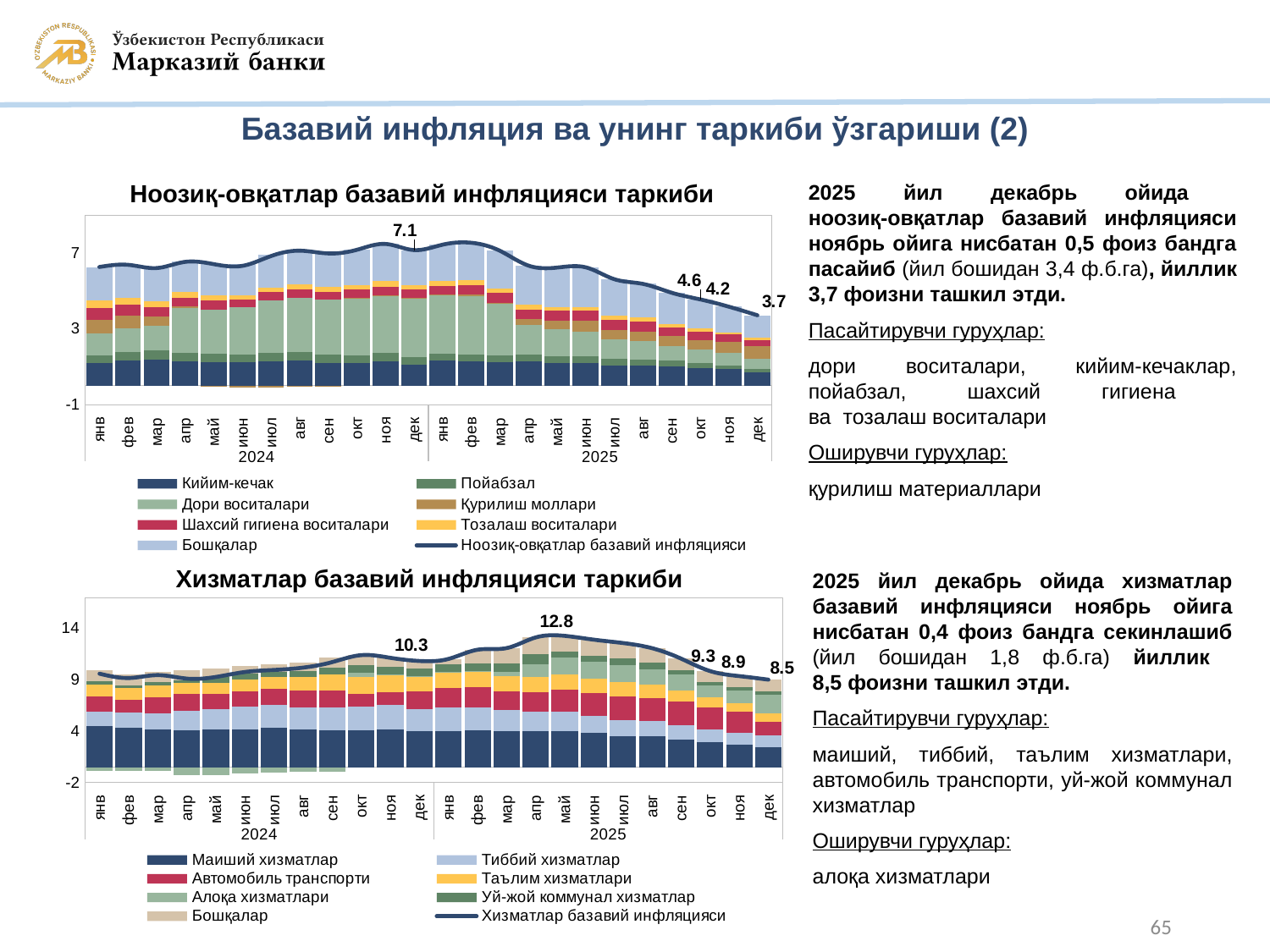
In the bottom chart (Хизматлар базавий инфляцияси таркиби), what is the difference between the line values for December 2024 (10.3) and December 2025 (8.5)? 1.8 In the bottom chart (Хизматлар базавий инфляцияси таркиби), which labelled point on the line is the highest? May 2025 (12.8) In the bottom chart (Хизматлар базавий инфляцияси таркиби), what is the value of the line for December 2025? 8.5 In the top chart (Ноозиқ-овқатлар базавий инфляцияси таркиби), does the line value rise or fall from December 2024 to December 2025? fall In the bottom chart (Хизматлар базавий инфляцияси таркиби), which is larger: the line value for October 2025 or for November 2025? October 2025 (9.3) In the top chart (Ноозиқ-овқатлар базавий инфляцияси таркиби), how many entries does the legend list? 8 In the top chart (Ноозиқ-овқатлар базавий инфляцияси таркиби), what is the value of the line for December 2025? 3.7 In the top chart (Ноозиқ-овқатлар базавий инфляцияси таркиби), what is the value of the line for October 2025? 4.6 What kind of chart is the bottom chart (Хизматлар базавий инфляцияси таркиби)? Stacked bar chart with a line In the top chart (Ноозиқ-овқатлар базавий инфляцияси таркиби), what value is labelled on the line for December 2024? 7.1 In the top chart (Ноозиқ-овқатлар базавий инфляцияси таркиби), by how much did the line value fall from November 2025 (4.2) to December 2025 (3.7)? 0.5 In the bottom chart (Хизматлар базавий инфляцияси таркиби), what is the value of the line for May 2025? 12.8